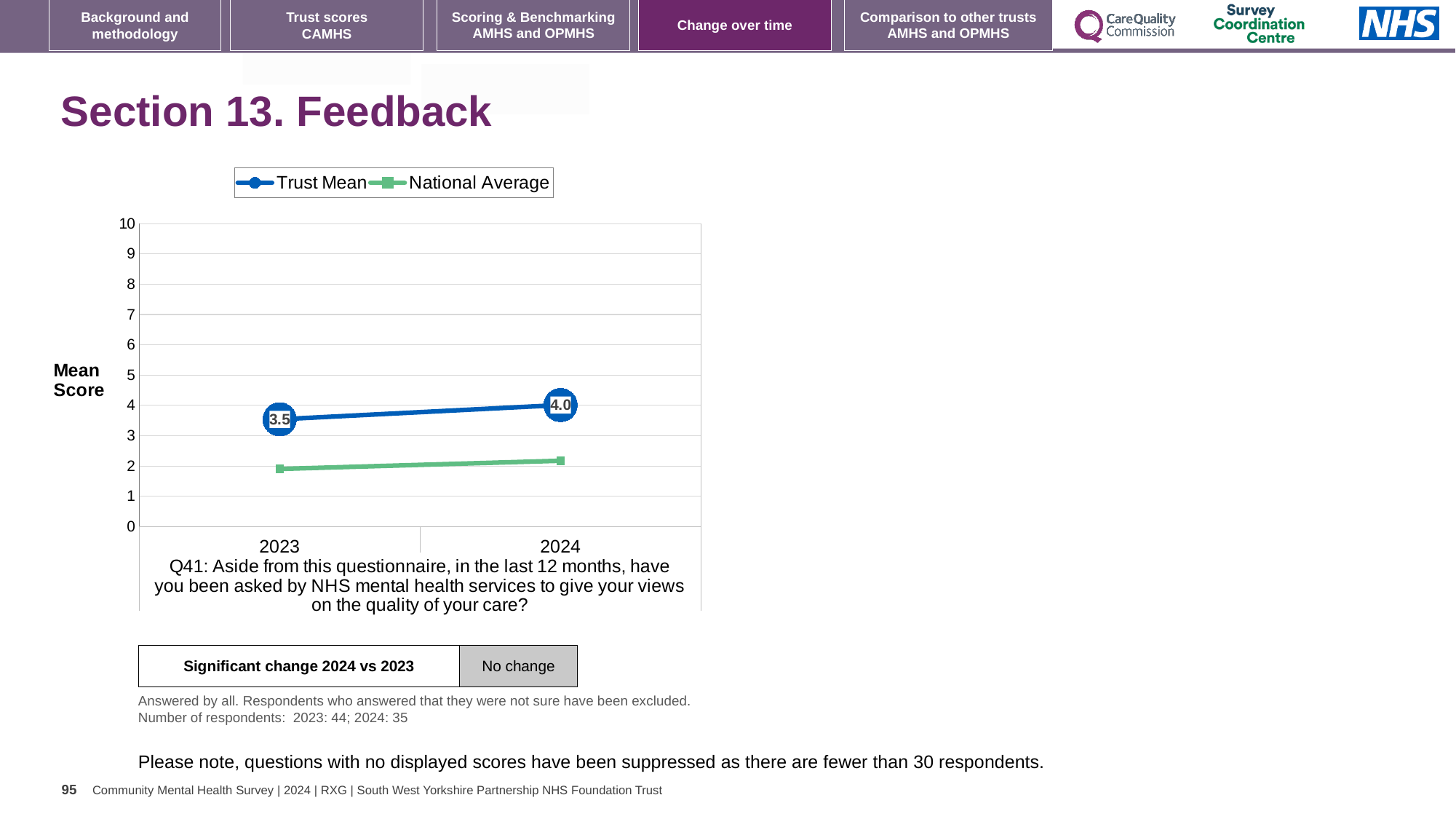
How many series does the chart legend list? 2 Does the Trust Mean rise or fall from 2023 to 2024? rise What is the difference between the Trust Mean scores for 2024 and 2023? 0.5 How many years are shown on the x axis of the chart? 2 What is the Trust Mean score for 2023? 3.5 What kind of chart is shown on the slide? line chart Is the National Average value for 2023 greater or less than 3? less Which is larger in 2024, the Trust Mean or the National Average? Trust Mean In which year is the Trust Mean score higher, 2023 or 2024? 2024 Is the National Average value for 2024 greater or less than 3? less What is the label on the y axis of the chart? Mean Score What is the Trust Mean score for 2024? 4.0